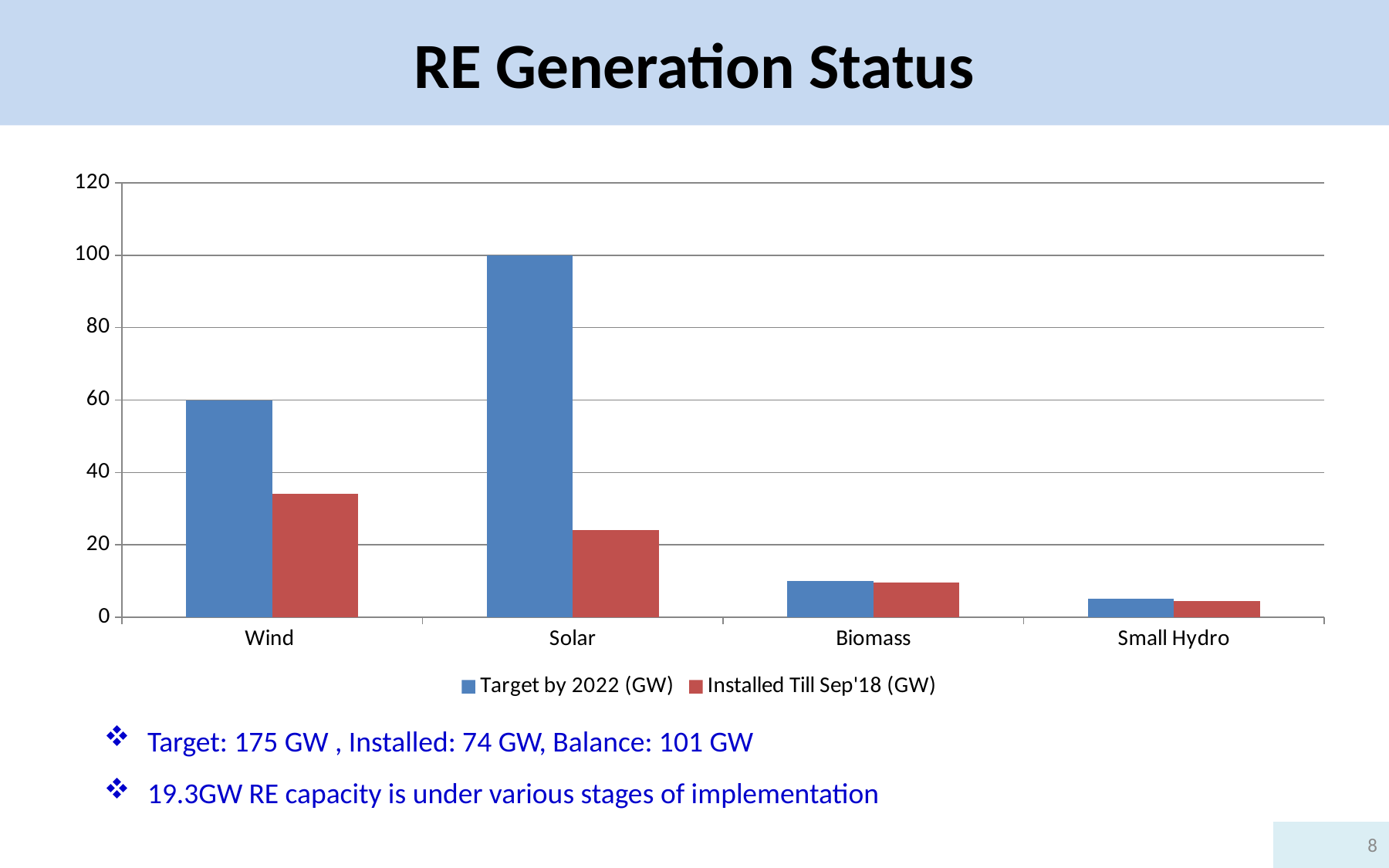
What is the Target by 2022 (GW) value for Solar? 100 What is the Target by 2022 (GW) value for Wind? 60 Is the Installed Till Sep'18 (GW) value for Solar greater or less than 20? greater How many series does the chart's legend list? 2 What is the title of the chart on the slide? RE Generation Status What kind of chart is shown on the slide? bar chart What is the difference between the Target by 2022 (GW) values for Solar and Wind? 40 Is the Installed Till Sep'18 (GW) value for Wind greater or less than 40? less Which category has the highest Target by 2022 (GW) value? Solar Which is larger, the Installed Till Sep'18 (GW) value for Wind or for Solar? Wind Which category has the lowest Target by 2022 (GW) value? Small Hydro How many categories are shown on the x axis of the chart? 4